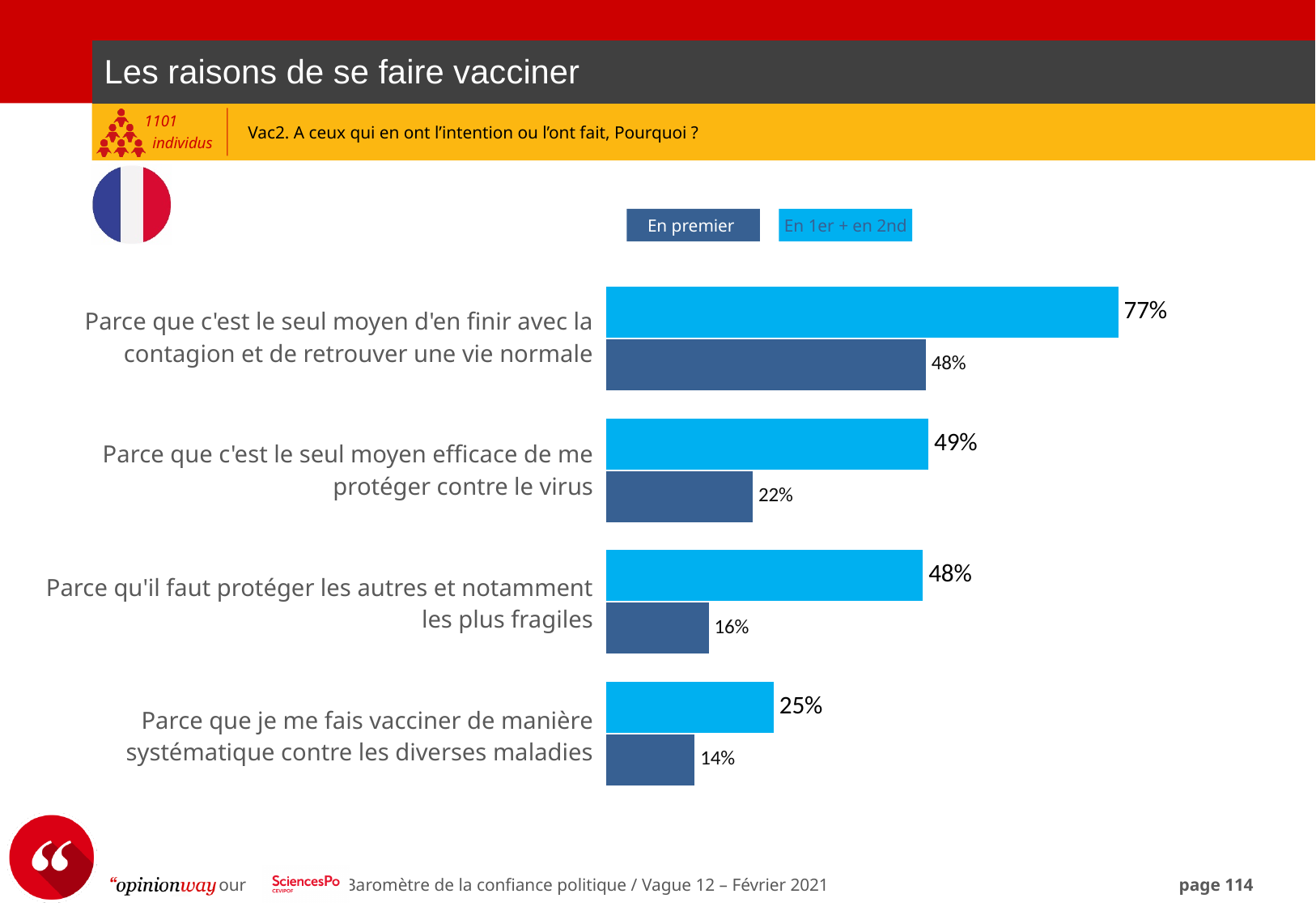
How many series does the legend list? 2 What is the 'En 1er + en 2nd' value for 'Parce que je me fais vacciner de manière systématique contre les diverses maladies'? 25% Which reason has the lowest 'En 1er + en 2nd' value? Parce que je me fais vacciner de manière systématique contre les diverses maladies What is the difference between the 'En 1er + en 2nd' values for 'Parce que c'est le seul moyen efficace de me protéger contre le virus' and 'Parce qu'il faut protéger les autres et notamment les plus fragiles'? 1% What is the difference between the 'En 1er + en 2nd' and 'En premier' values for 'Parce que c'est le seul moyen d'en finir avec la contagion et de retrouver une vie normale'? 29% How many reasons (categories) are shown in the chart? 4 What is the 'En 1er + en 2nd' value for 'Parce que c'est le seul moyen d'en finir avec la contagion et de retrouver une vie normale'? 77% What is the 'En premier' value for 'Parce qu'il faut protéger les autres et notamment les plus fragiles'? 16% Which is larger: the 'En premier' value for 'Parce que c'est le seul moyen efficace de me protéger contre le virus' or for 'Parce que je me fais vacciner de manière systématique contre les diverses maladies'? Parce que c'est le seul moyen efficace de me protéger contre le virus What is the 'En premier' value for 'Parce que c'est le seul moyen efficace de me protéger contre le virus'? 22% Which reason has the highest 'En premier' value? Parce que c'est le seul moyen d'en finir avec la contagion et de retrouver une vie normale What kind of chart is shown on the slide? Bar chart